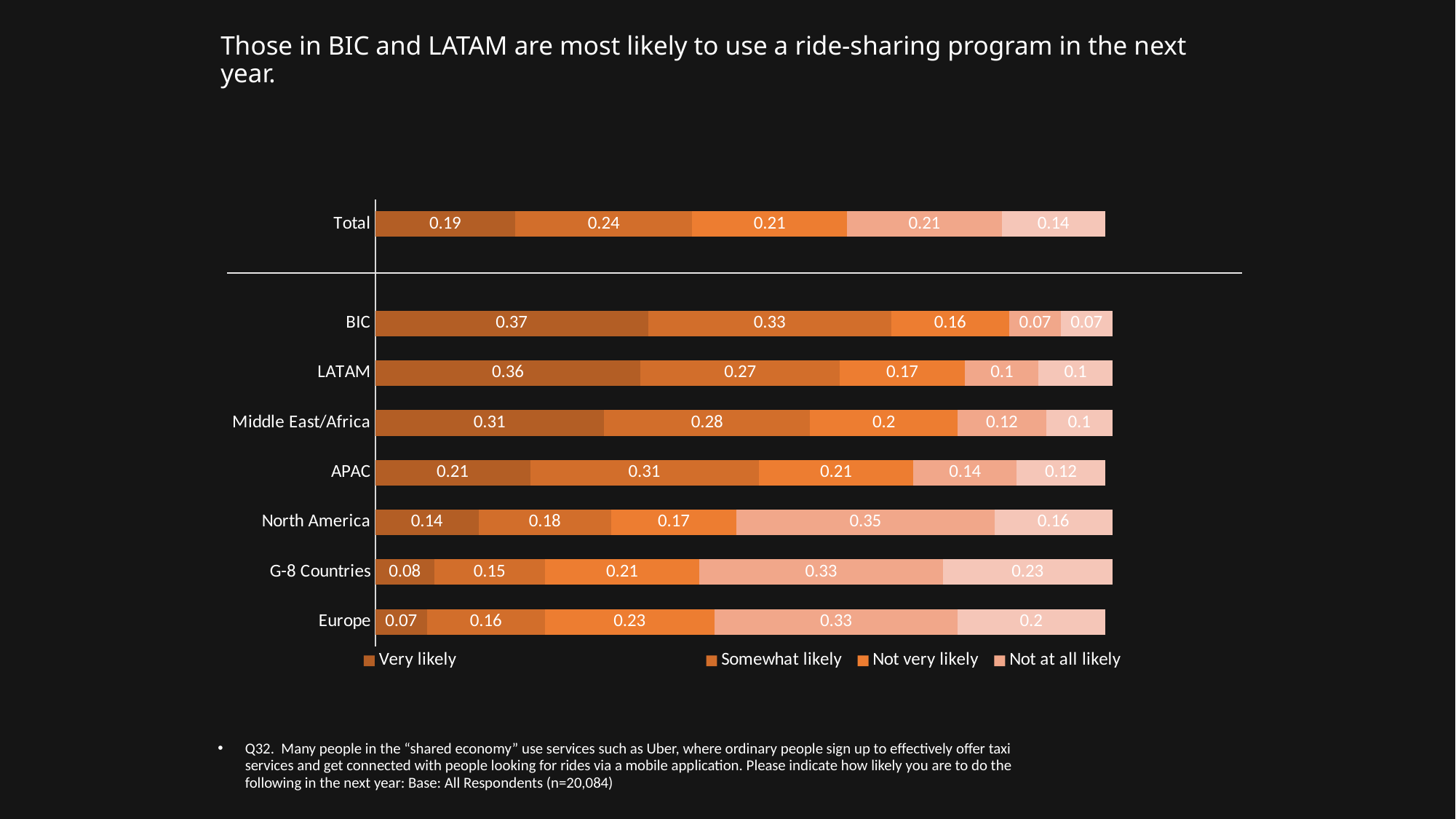
What is the 'Very likely' value for Total? 0.19 What is the 'Very likely' value for BIC? 0.37 What is the difference between the 'Very likely' values for BIC and Europe? 0.3 What kind of chart is shown on the slide? Stacked bar chart Which category has the highest 'Very likely' value? BIC Which category has the lowest 'Very likely' value? Europe What is the first entry listed in the legend? Very likely What is the total of all segments in the BIC bar? 1 Which has the larger 'Somewhat likely' value, BIC or APAC? BIC What is the 'Not very likely' value for Europe? 0.23 What is the 'Somewhat likely' value for LATAM? 0.27 How many regional categories (including Total) are plotted on the chart? 8